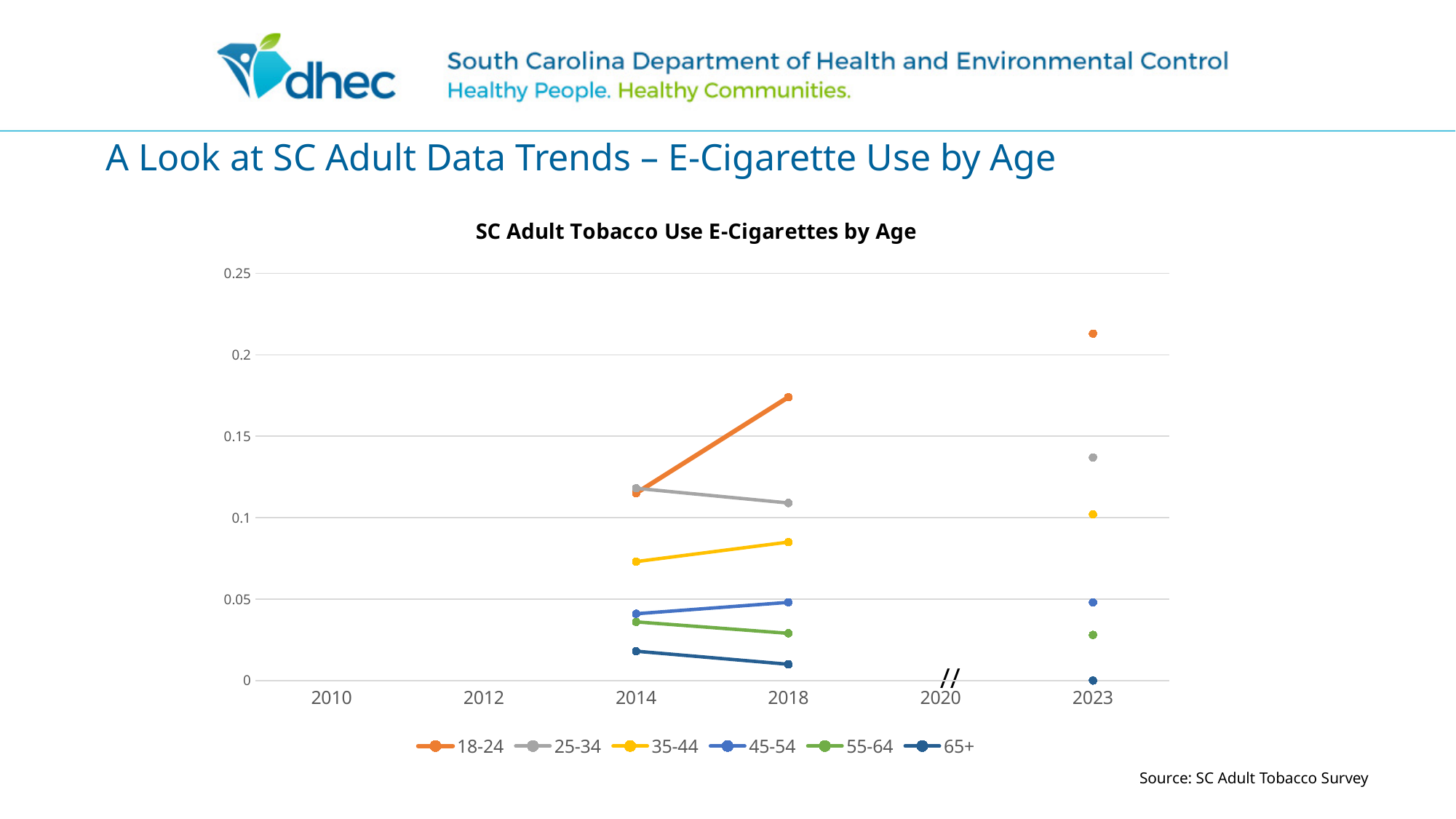
In 2018, which age group has the higher value: 35-44 or 45-54? 35-44 Is the value for the 35-44 age group in 2014 greater or less than 0.1? less Is the value for the 18-24 age group in 2023 greater or less than 0.2? greater Which age group has the highest e-cigarette use in 2023? 18-24 Is the value for the 65+ age group in 2018 greater or less than 0.05? less What is the title of the chart? SC Adult Tobacco Use E-Cigarettes by Age What type of chart is shown on the slide? line chart Which age group has the lowest e-cigarette use in 2023? 65+ How many age groups does the legend list? 6 Does e-cigarette use for the 65+ age group rise or fall from 2014 to 2023? fall Does e-cigarette use for the 18-24 age group rise or fall from 2014 to 2023? rise